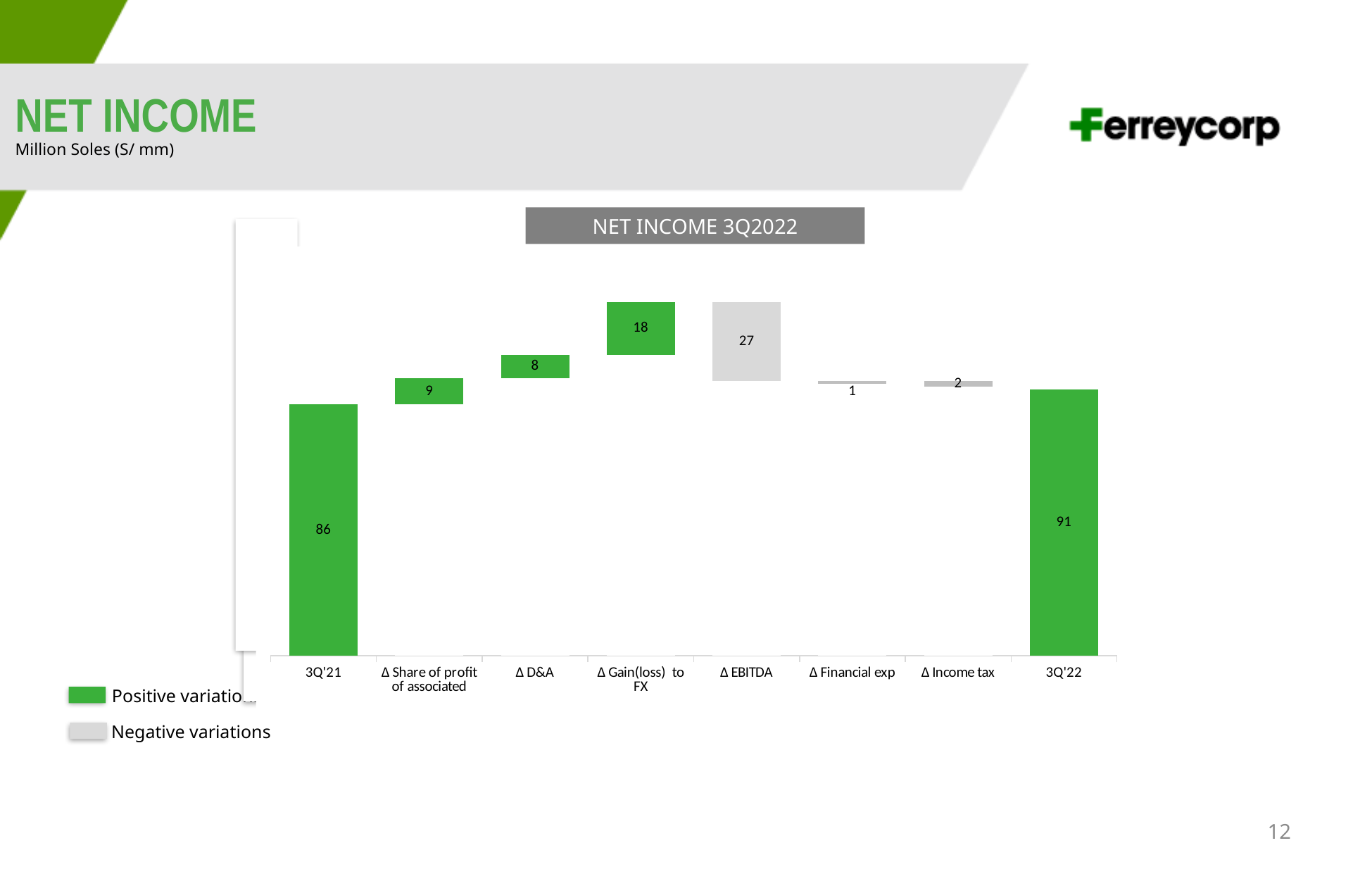
What is the value shown for Δ Gain(loss) to FX? 18 What is the net income value for 3Q'22? 91 By how much does net income in 3Q'22 exceed net income in 3Q'21? 5 How many categories are shown on the x axis of the chart? 8 What is the value shown for Δ Share of profit of associated? 9 Which variation item has the largest value? Δ EBITDA What is the title of the chart? NET INCOME 3Q2022 Which is larger, the value for Δ D&A or the value for Δ Income tax? Δ D&A According to the legend, what do the grey bars represent? Negative variations What is the net income value for 3Q'21? 86 What is the value shown for Δ EBITDA? 27 Which variation item has the smallest value? Δ Financial exp